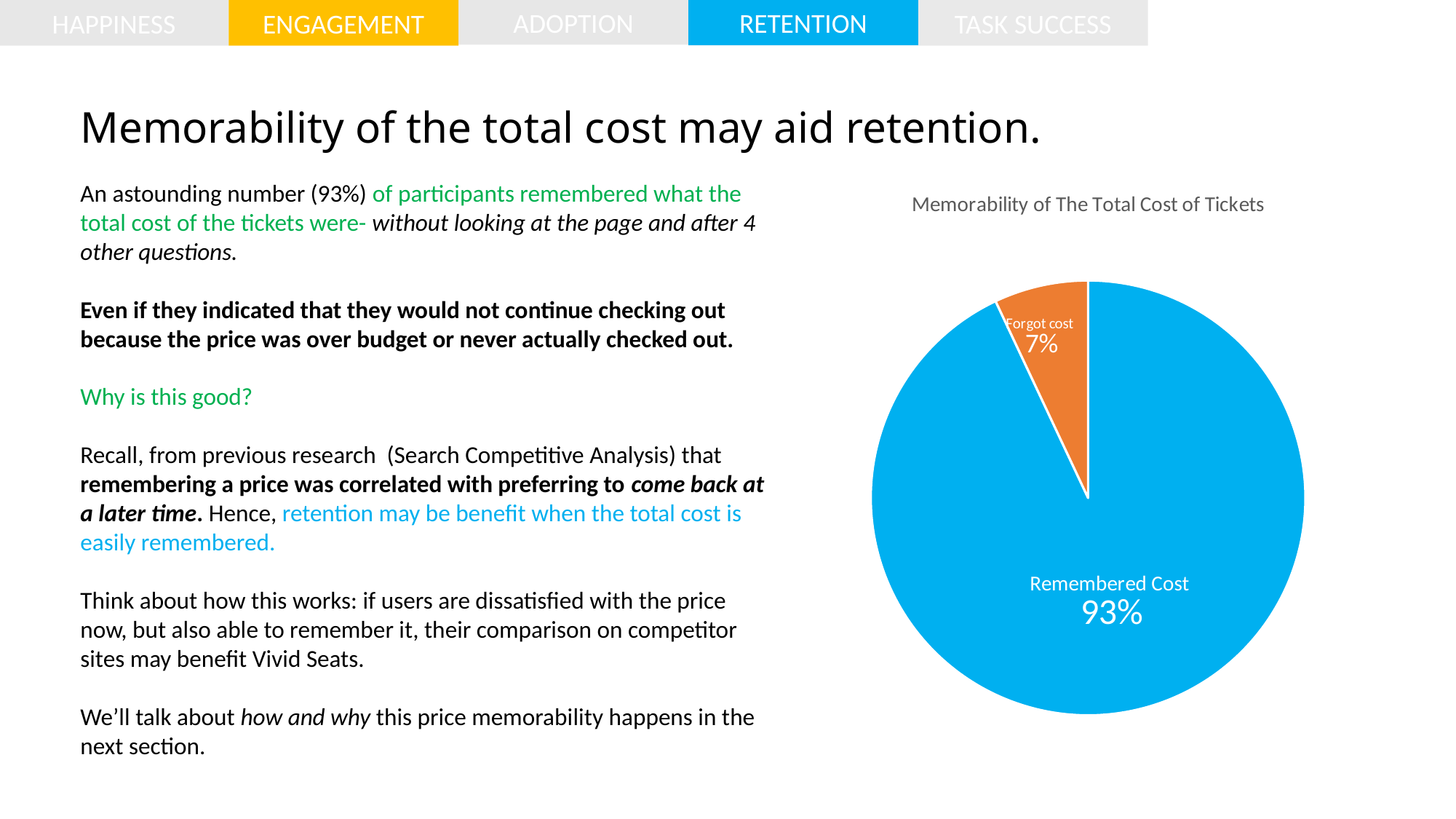
What share of the pie is labelled Remembered Cost? 93% Which slice of the pie is the largest? Remembered Cost Which is larger, the Forgot cost slice or the Remembered Cost slice? Remembered Cost What share of the pie is labelled Forgot cost? 7% How many slices does the pie chart have? 2 Which slice of the pie is the smallest? Forgot cost What colour is the Forgot cost slice? orange What is the title of the chart? Memorability of The Total Cost of Tickets What kind of chart is shown on the slide? pie chart What is the difference in percentage points between the Remembered Cost slice and the Forgot cost slice? 86